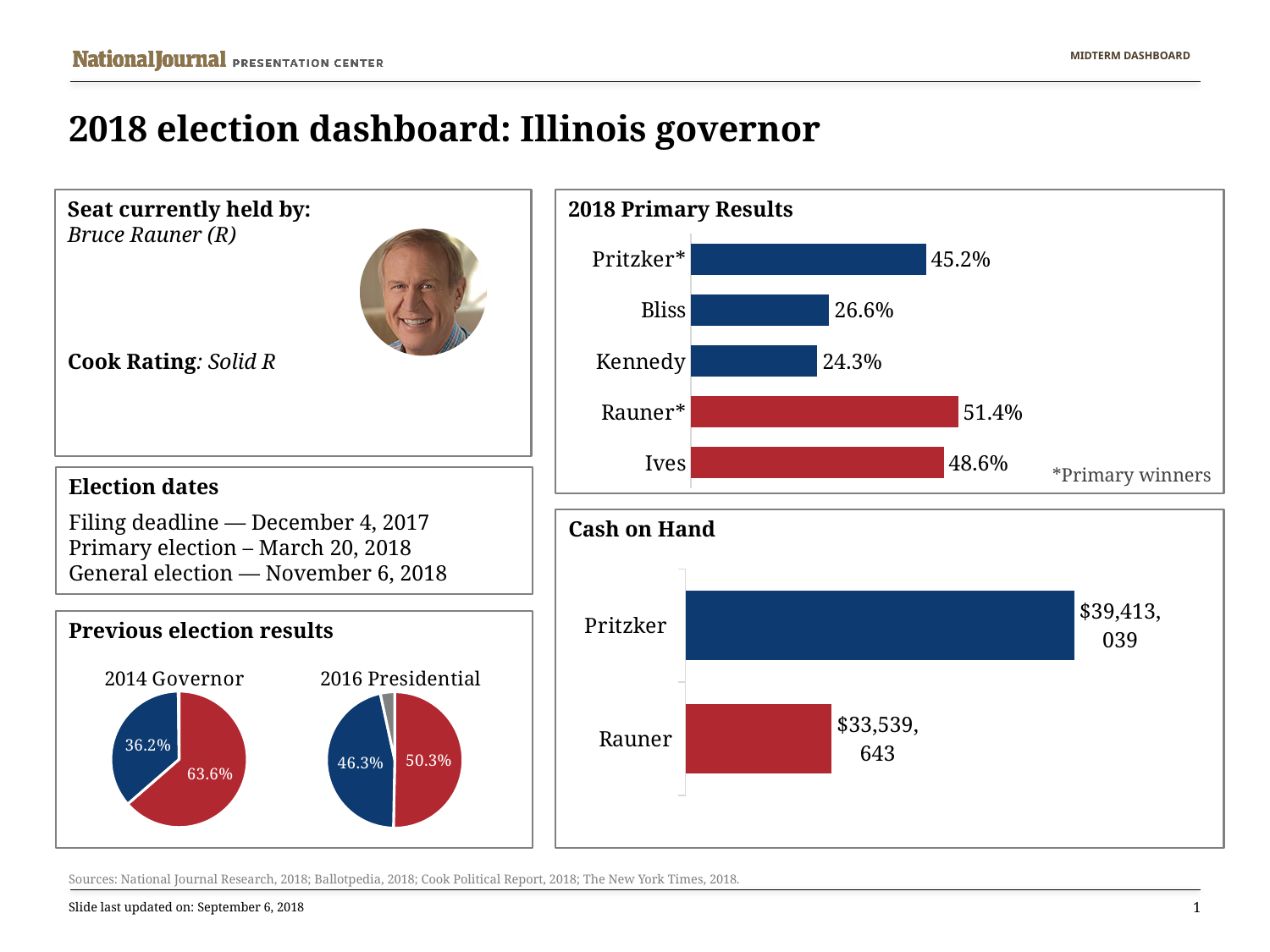
In the 2018 Primary Results chart, which candidate has the lowest percentage? Kennedy In the 2018 Primary Results chart, what percentage did Ives receive? 48.6% In the 2014 Governor pie chart, what share does the red slice represent? 63.6% How many candidates are shown in the 2018 Primary Results chart? 5 In the 2018 Primary Results chart, which candidate has the highest percentage? Rauner* In the Cash on Hand chart, what is the difference between Pritzker's and Rauner's cash on hand? $5,873,396 In the Cash on Hand chart, how much cash does Rauner have? $33,539,643 In the 2016 Presidential pie chart, what share does the blue slice represent? 46.3% In the 2018 Primary Results chart, what is the difference between Rauner's and Ives's percentages? 2.8% In the 2018 Primary Results chart, what percentage did Pritzker receive? 45.2% In the 2018 Primary Results chart, who received a higher percentage, Bliss or Kennedy? Bliss What type of chart is the Cash on Hand chart? Bar chart